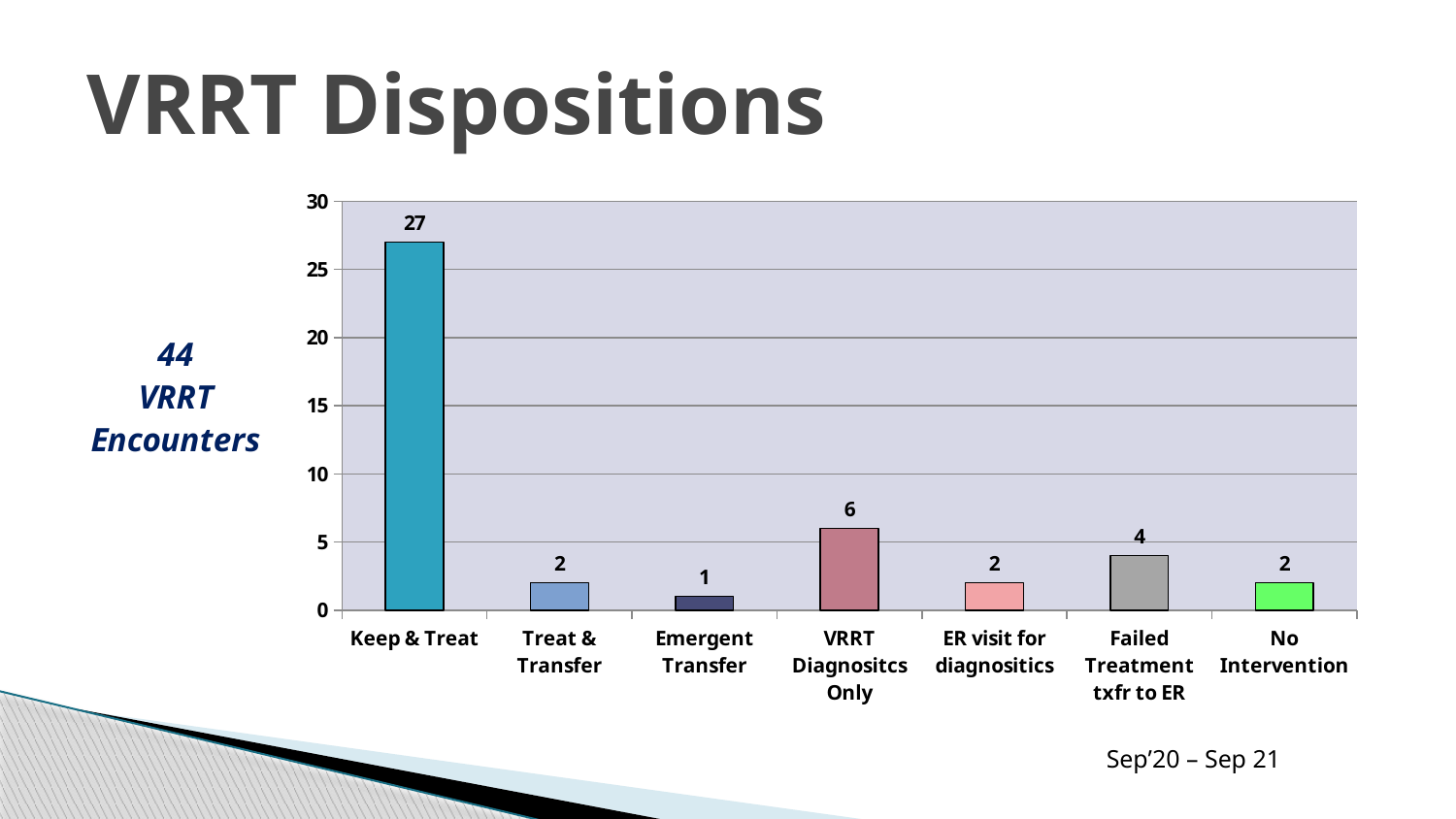
What is the value for Failed Treatment txfr to ER? 4 What is the value for Emergent Transfer? 1 Which category has the lowest value? Emergent Transfer What is the difference between Keep & Treat and VRRT Diagnositcs Only? 21 How many categories are shown on the x axis? 7 What kind of chart is shown on the slide? bar chart What is the value for VRRT Diagnositcs Only? 6 What is the title of the slide containing the chart? VRRT Dispositions Which category has the highest value? Keep & Treat Is the value for Keep & Treat greater or less than 25? greater What is the value for Keep & Treat? 27 Which is larger, VRRT Diagnositcs Only or Failed Treatment txfr to ER? VRRT Diagnositcs Only